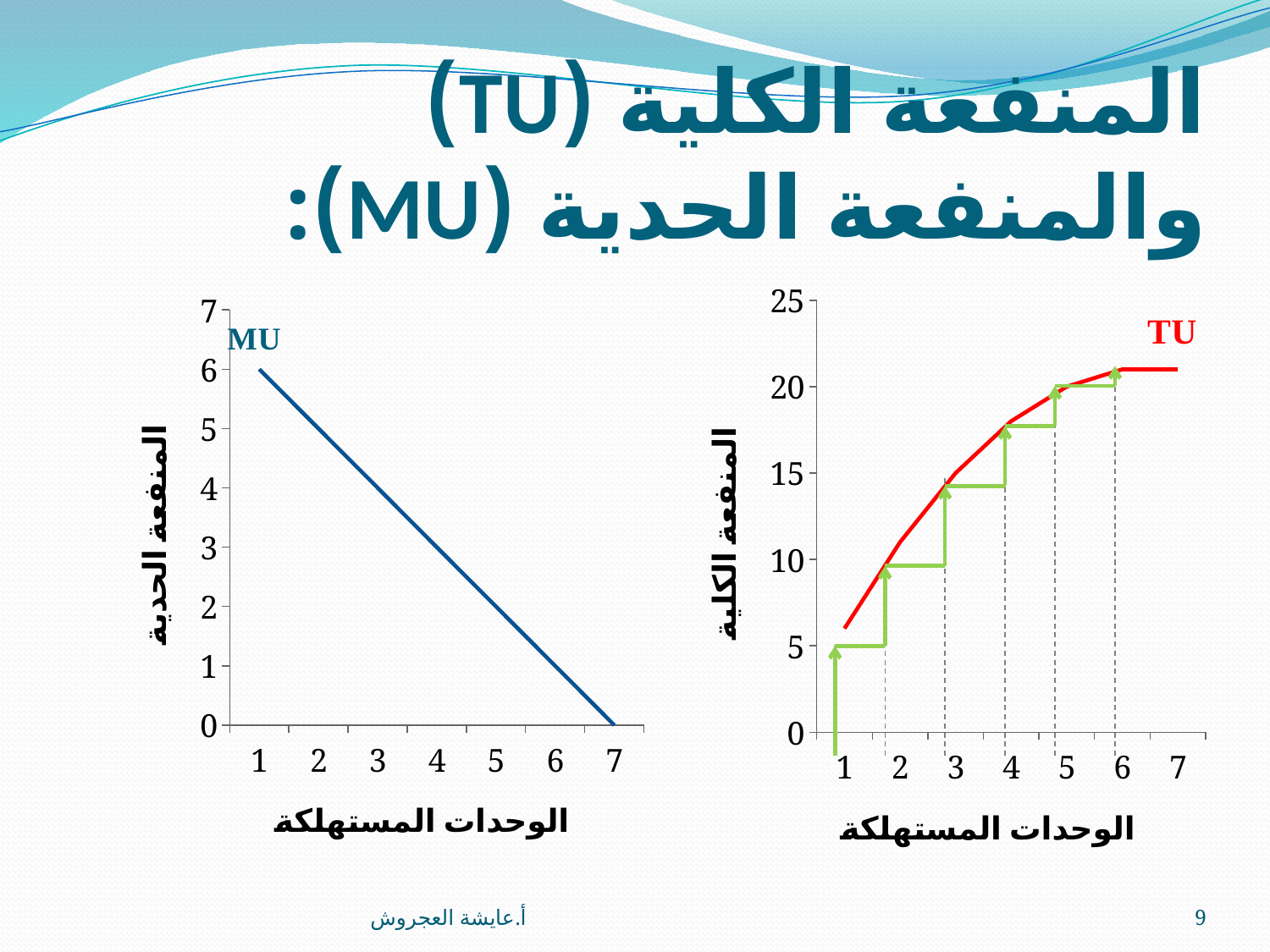
How many units-consumed values are marked on the x axis of the right TU chart? 7 In the left MU chart, what is the value of MU at 1 unit consumed? 6 In the right TU chart, is the value of TU at 6 units consumed greater or less than 15? greater In the left MU chart, at which number of units consumed is MU highest? 1 In the left MU chart, do the values rise or fall as the number of units consumed increases? fall In the left MU chart, what is the value of MU at 7 units consumed? 0 In the right TU chart, is the value of TU at 1 unit consumed greater or less than 10? less In the right TU chart, do the values rise or fall as the number of units consumed increases? rise What kind of chart is the right chart labelled TU? line chart What kind of chart is the left chart labelled MU? line chart In the left MU chart, at which number of units consumed is MU lowest? 7 In the left MU chart, which is larger: MU at 2 units or MU at 5 units? 2 units